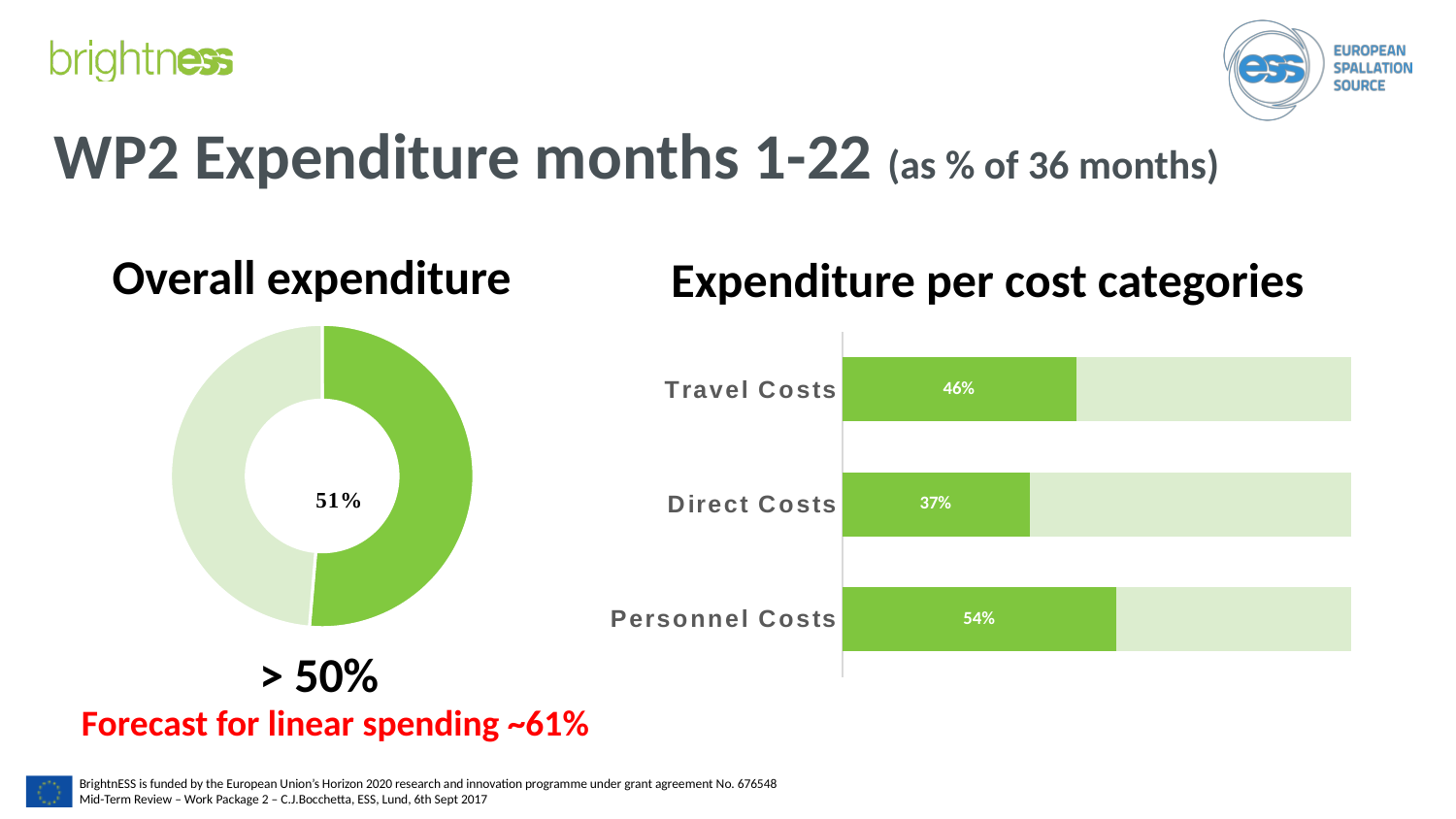
In the Expenditure per cost categories chart, what is the difference between Personnel Costs and Direct Costs? 17% In the Expenditure per cost categories chart, which cost category has the lowest value? Direct Costs What is the title of the chart on the right side of the slide? Expenditure per cost categories How many cost categories are shown in the Expenditure per cost categories chart? 3 What kind of chart is the Overall expenditure chart? Donut chart What percentage is labelled on the Overall expenditure chart? 51% In the Expenditure per cost categories chart, which cost category has the highest value? Personnel Costs In the Expenditure per cost categories chart, what is the value for Personnel Costs? 54% In the Expenditure per cost categories chart, what is the value for Direct Costs? 37% In the Expenditure per cost categories chart, what is the value for Travel Costs? 46% What kind of chart is the Expenditure per cost categories chart? Bar chart In the Expenditure per cost categories chart, which is larger, Travel Costs or Direct Costs? Travel Costs